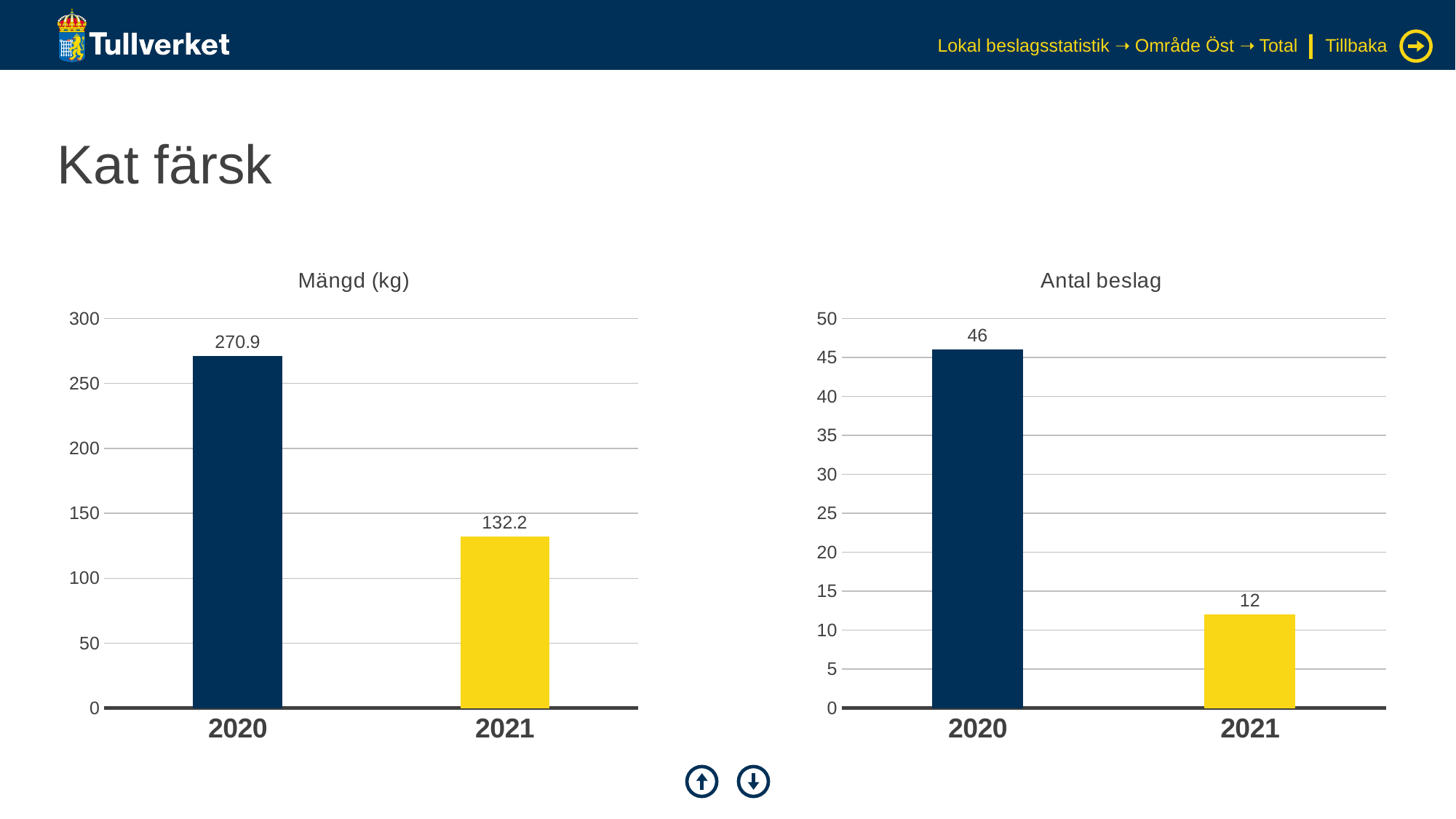
In the 'Antal beslag' chart, is the value for 2020 larger or smaller than the value for 2021? larger In the 'Mängd (kg)' chart, is the value for 2021 greater or less than 150? less What kind of chart is the 'Mängd (kg)' chart? bar chart In the 'Antal beslag' chart, what is the value for 2020? 46 In the 'Mängd (kg)' chart, which year has the highest value? 2020 In the 'Antal beslag' chart, which year has the lowest value? 2021 In the 'Antal beslag' chart, what is the value for 2021? 12 How many categories does the 'Antal beslag' chart show? 2 In the 'Mängd (kg)' chart, what is the difference between the 2020 and 2021 values? 138.7 In the 'Mängd (kg)' chart, what is the value for 2020? 270.9 In the 'Antal beslag' chart, what is the difference between the 2020 and 2021 values? 34 In the 'Mängd (kg)' chart, what is the value for 2021? 132.2